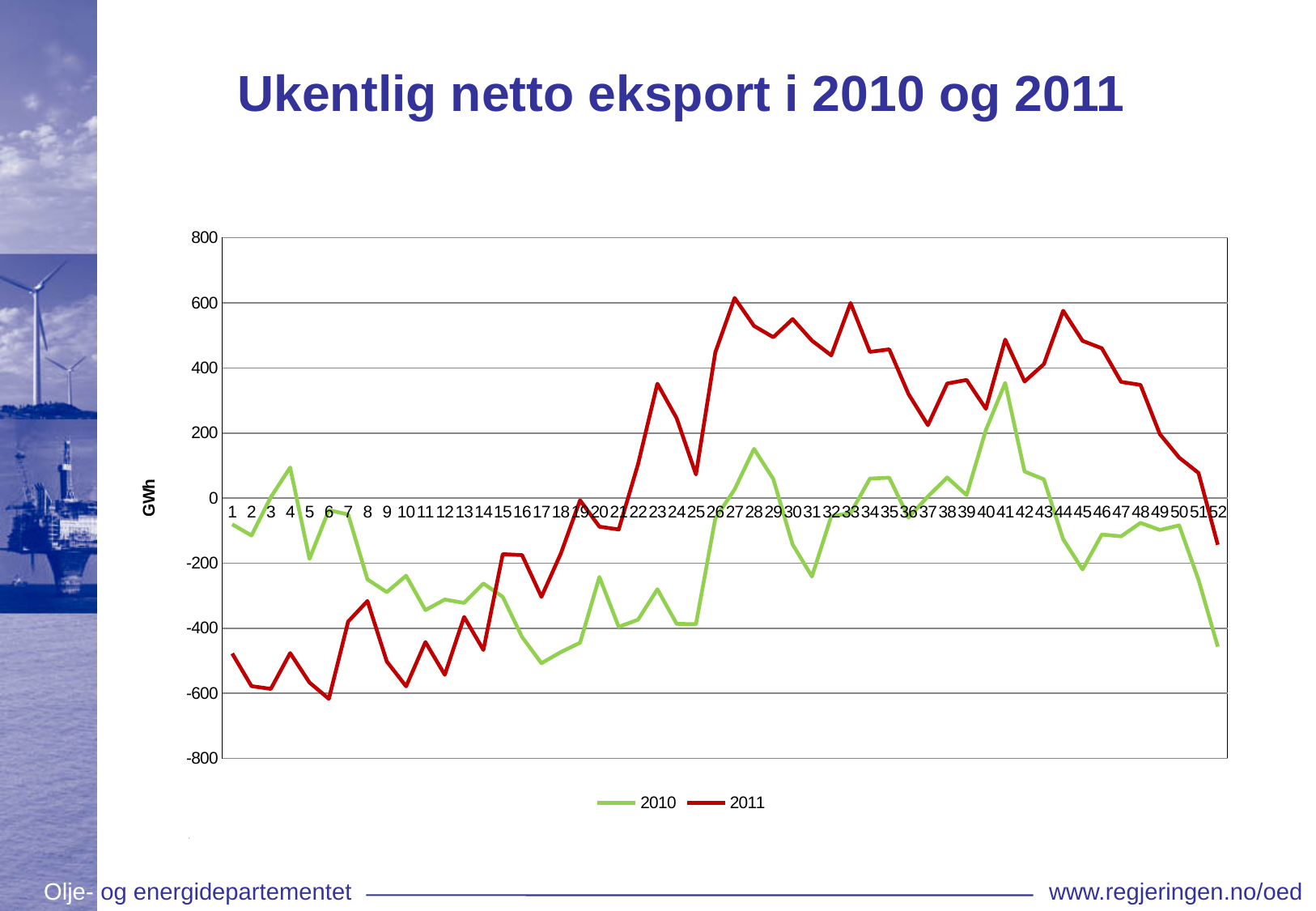
Which two series are listed in the legend? 2010 and 2011 In week 4, which series has the larger value, 2010 or 2011? 2010 In week 27, which series has the larger value, 2010 or 2011? 2011 How many series does the legend list? 2 What is the label on the vertical axis? GWh Is the value for 2010 in week 41 greater or less than 200? greater What kind of chart is shown on the slide? line chart Is the value for 2010 in week 52 greater or less than -200? less Do the values for 2011 rise or fall from week 44 to week 52? fall How many weeks are plotted along the x axis? 52 Is the value for 2011 in week 27 greater or less than 400? greater